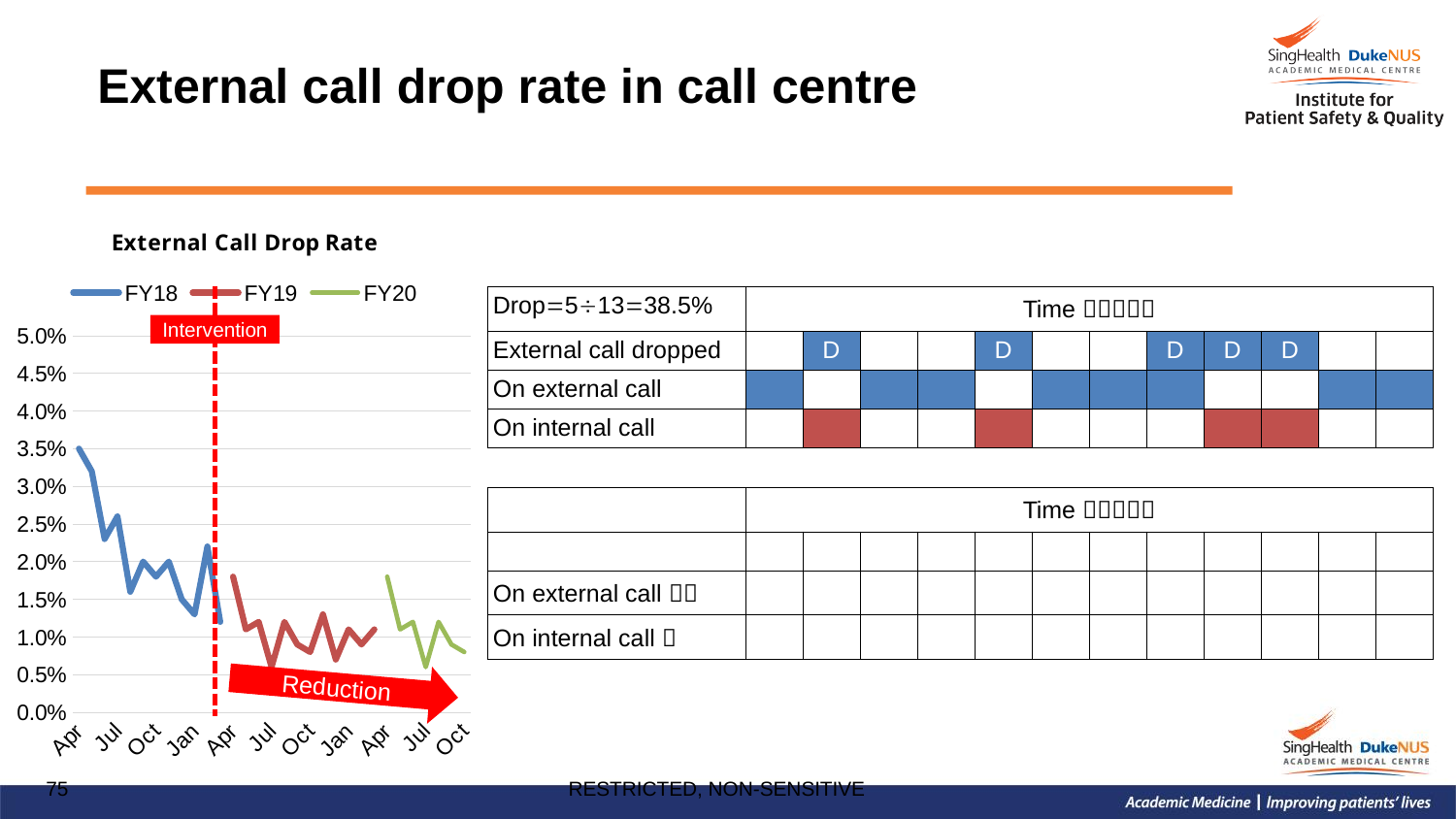
Does the FY18 series rise or fall from Apr to the following Apr? fall What is the title of the chart on the slide? External Call Drop Rate Which series in the chart is drawn in green? FY20 What is the highest value shown on the y axis of the chart? 5.0% Is the FY19 value at Apr greater or less than 1.0%? greater Which series reaches the highest drop rate in the chart? FY18 Which is larger: the FY18 value at its first Apr or the FY19 value at its first Apr? FY18 Is the FY20 value at the final Oct greater or less than 1.0%? less Is the FY18 value at the first Apr greater or less than 3.0%? greater What type of chart is shown on the slide? line chart How many series does the legend of the External Call Drop Rate chart list? 3 How many month labels are shown along the x axis of the chart? 11